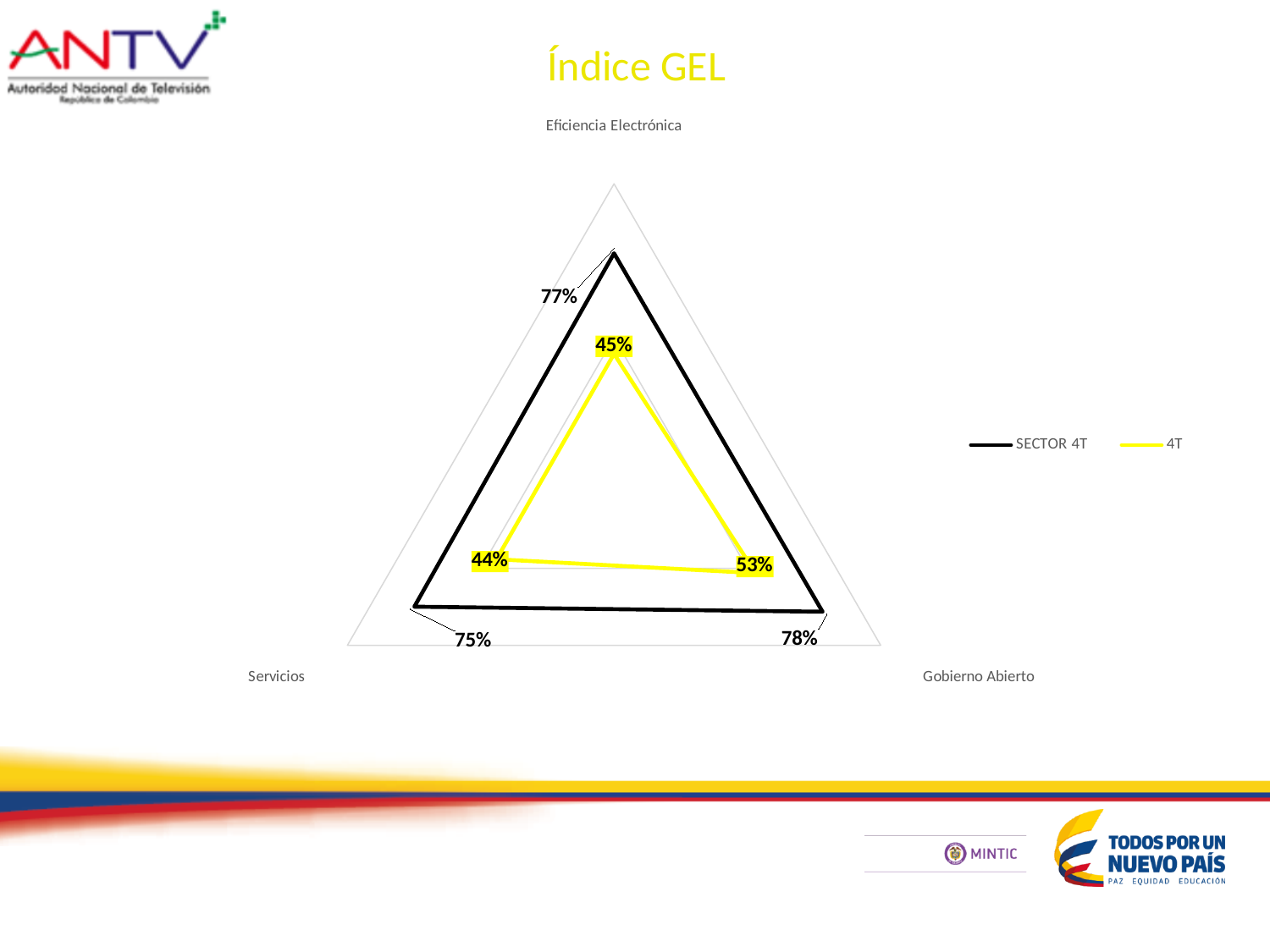
Which category has the lowest value for the SECTOR 4T series? Servicios What is the title of the chart? Índice GEL What is the difference between the SECTOR 4T and 4T values for Gobierno Abierto? 25% What is the SECTOR 4T value for Servicios? 75% How many categories (axes) does the radar chart have? 3 Which category has the highest value for the 4T series? Gobierno Abierto What is the SECTOR 4T value for Eficiencia Electrónica? 77% Which series is drawn in yellow? 4T How many series does the legend list? 2 What is the 4T value for Gobierno Abierto? 53% What is the 4T value for Servicios? 44% What kind of chart is shown on the slide? Radar chart